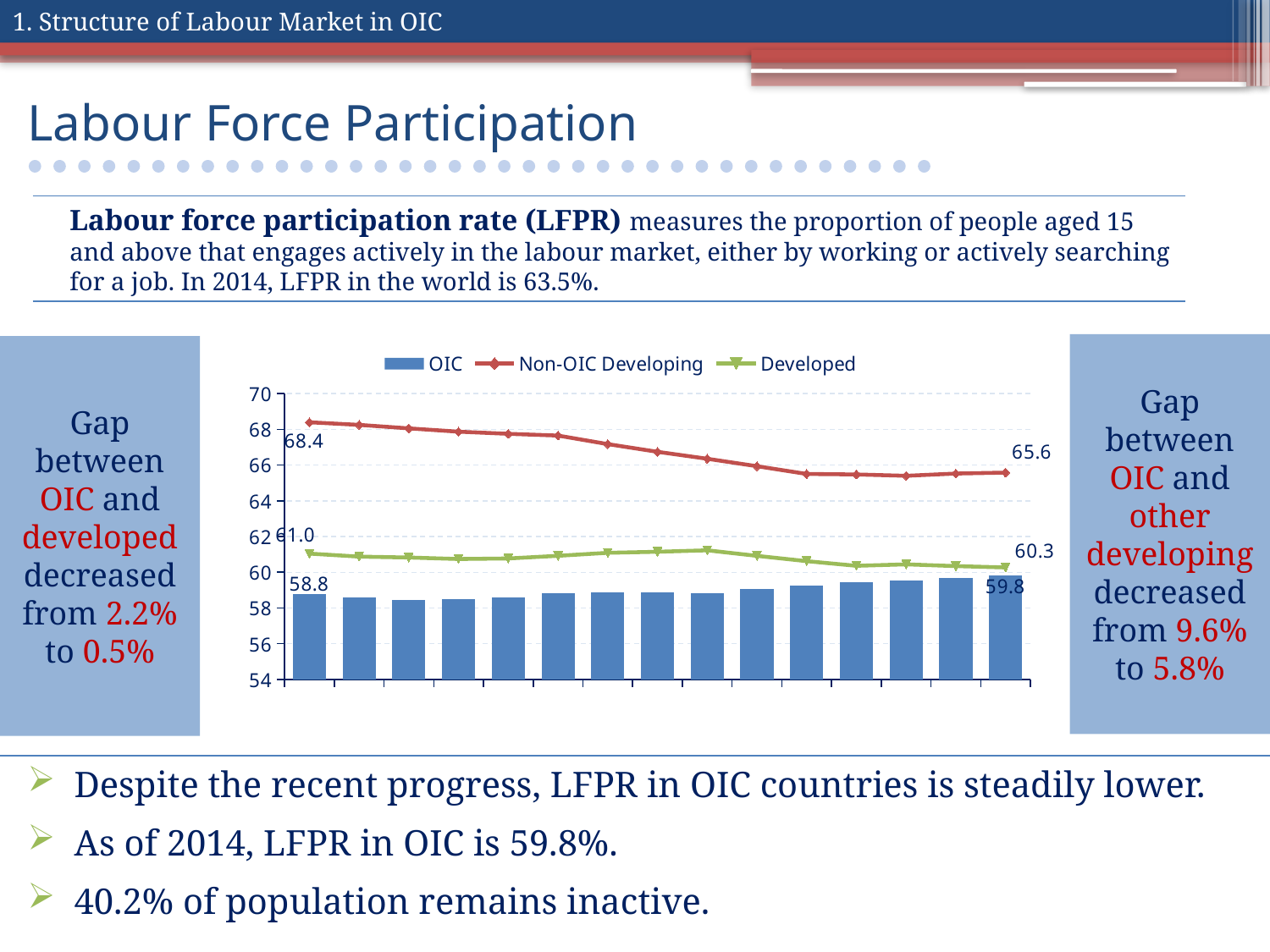
By how much did the Non-OIC Developing series fall from its first labelled value (68.4) to its last labelled value (65.6)? 2.8 What is the first labelled value of the OIC series? 58.8 How many series does the chart legend list? 3 What is the last labelled value of the OIC series? 59.8 Which series has the highest values throughout the chart? Non-OIC Developing Is the last OIC bar value greater or less than 60? less What is the first labelled value of the Non-OIC Developing series? 68.4 What kind of chart is shown on the slide? Combination bar and line chart Does the Non-OIC Developing line rise or fall from left to right? Fall At the right end of the chart, which is larger: the Non-OIC Developing value or the Developed value? Non-OIC Developing What is the last labelled value of the Developed series? 60.3 What is the difference between the last labelled Non-OIC Developing value (65.6) and the last labelled OIC value (59.8)? 5.8